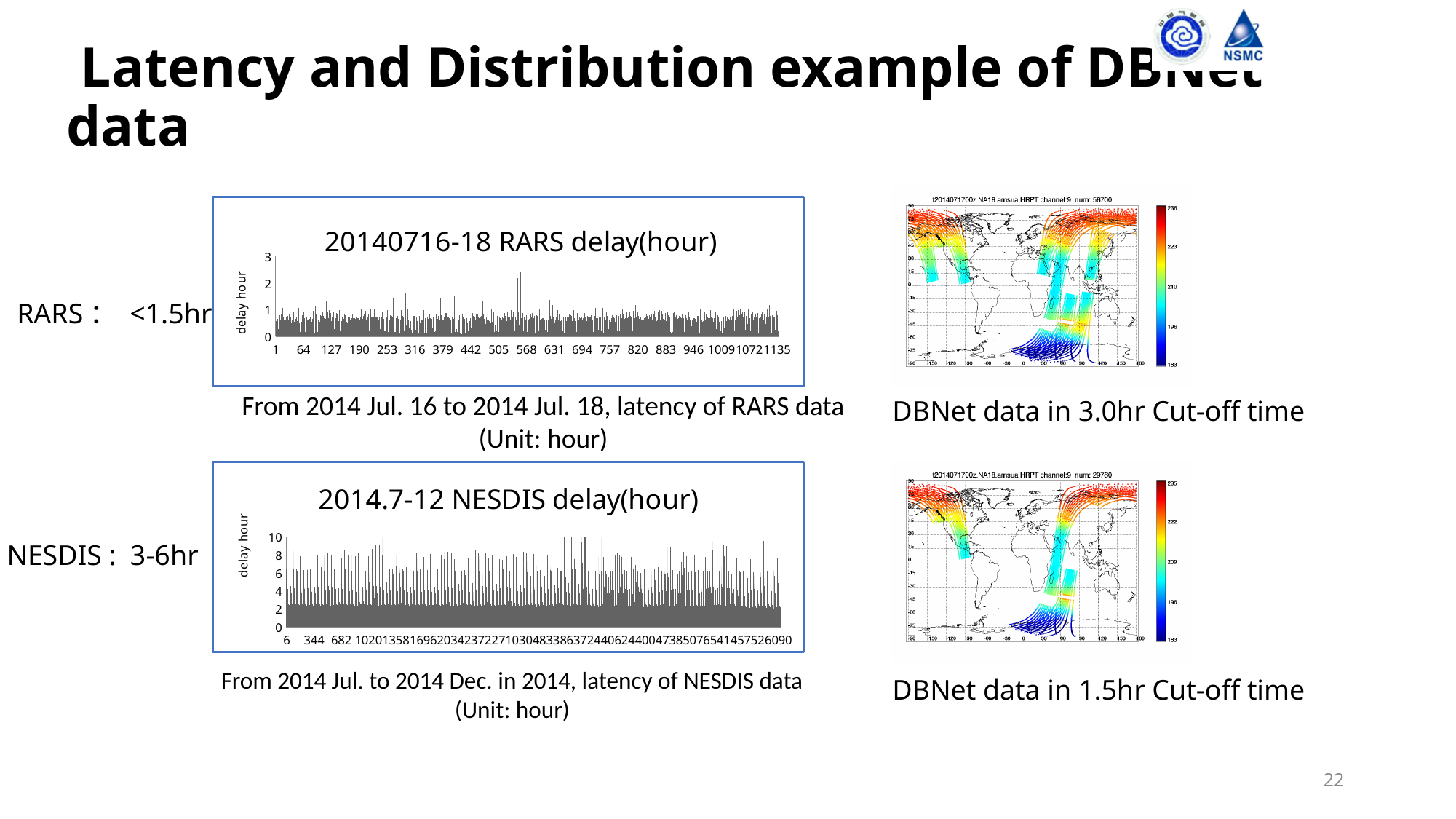
What is the title of the upper chart on the left of the slide? 20140716-18 RARS delay(hour) In the '2014.7-12 NESDIS delay(hour)' chart, is the highest delay value greater or less than 8? greater How many bar charts are shown on the slide? 2 Which chart shows a higher maximum delay, the '20140716-18 RARS delay(hour)' chart or the '2014.7-12 NESDIS delay(hour)' chart? 2014.7-12 NESDIS delay(hour) In the '20140716-18 RARS delay(hour)' chart, is the highest delay value greater or less than 2? greater In the '2014.7-12 NESDIS delay(hour)' chart, is the lowest delay value greater or less than 4? less What is the y-axis label of the '2014.7-12 NESDIS delay(hour)' chart? delay hour What kind of chart is the '20140716-18 RARS delay(hour)' chart? bar chart What is the highest tick value on the y-axis of the '20140716-18 RARS delay(hour)' chart? 3 What kind of chart is the '2014.7-12 NESDIS delay(hour)' chart? bar chart